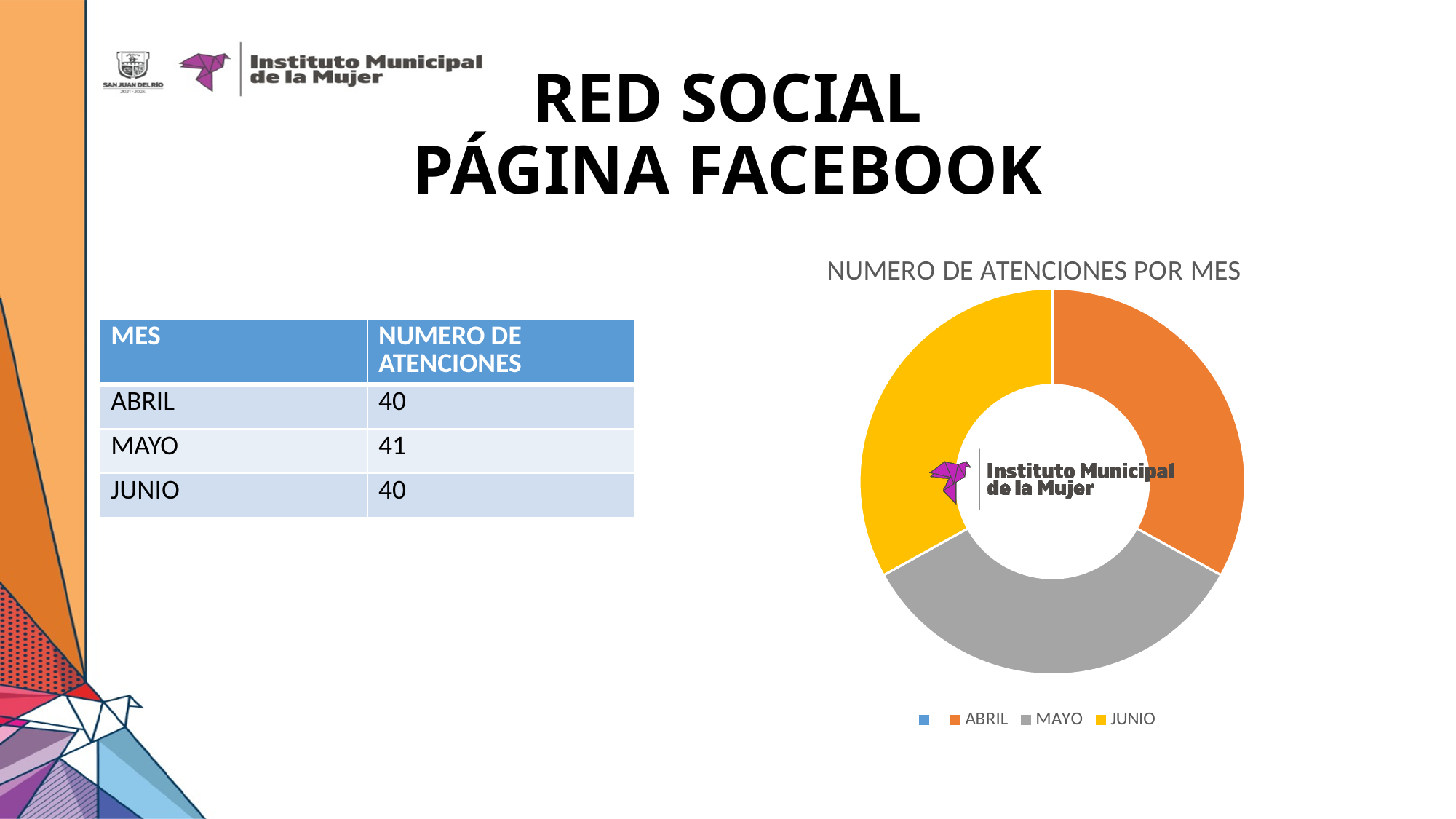
Using the values in the table, what is the difference between the atenciones in MAYO and ABRIL? 1 Which colour represents MAYO in the chart "NUMERO DE ATENCIONES POR MES"? gray According to the table next to the chart, how many atenciones were there in JUNIO? 40 How many slices does the doughnut chart "NUMERO DE ATENCIONES POR MES" have? 3 According to the table next to the chart, how many atenciones were there in ABRIL? 40 Which months are listed in the legend of the chart "NUMERO DE ATENCIONES POR MES"? ABRIL, MAYO, JUNIO What is the title of the doughnut chart on the slide? NUMERO DE ATENCIONES POR MES According to the table next to the chart, how many atenciones were there in MAYO? 41 How many months are named in the legend of the chart "NUMERO DE ATENCIONES POR MES"? 3 What kind of chart is shown under the title "NUMERO DE ATENCIONES POR MES"? doughnut (pie) chart